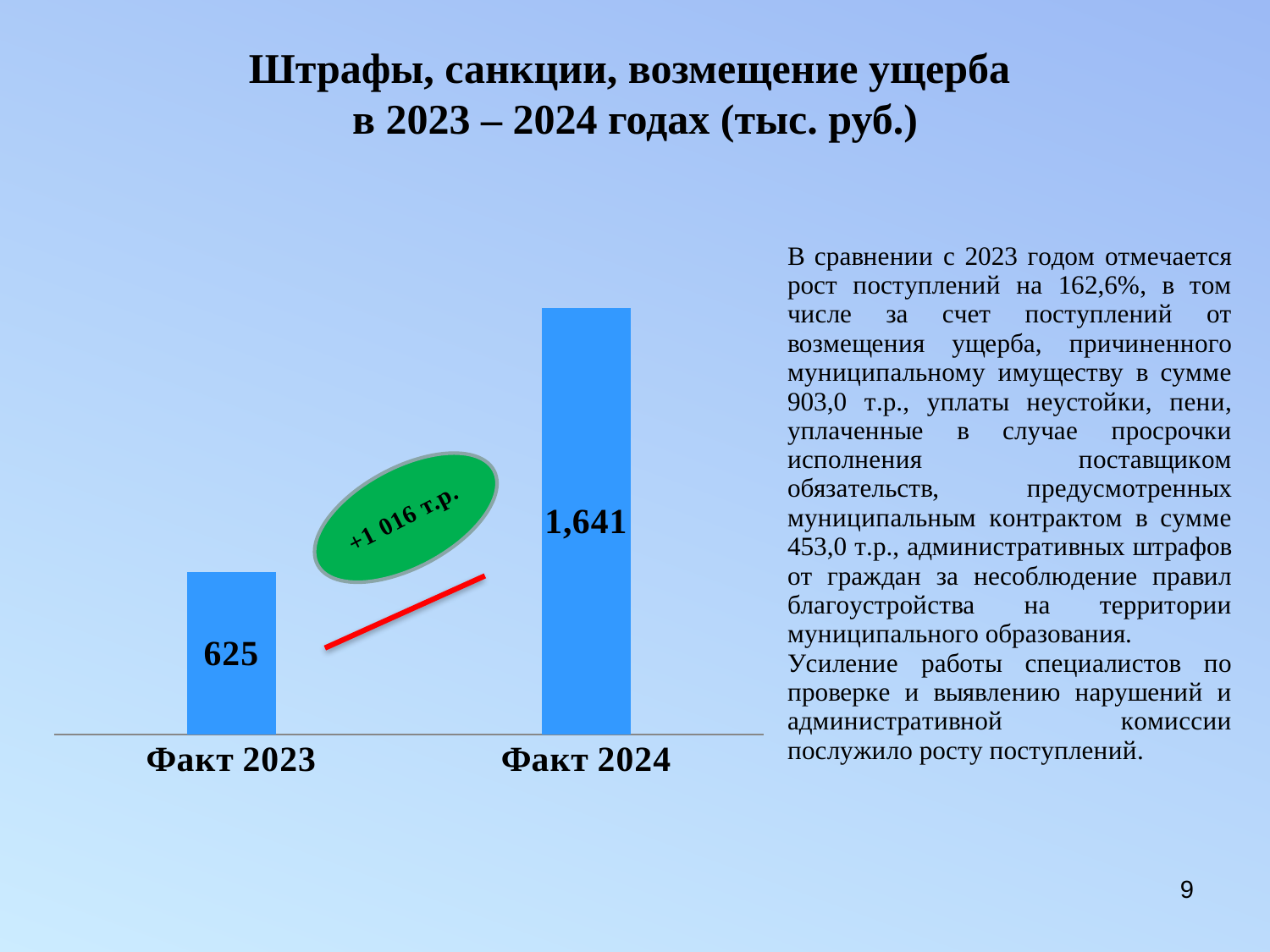
Which is larger, the value for Факт 2023 or the value for Факт 2024? Факт 2024 Which category has the lowest value? Факт 2023 What kind of chart is shown on the slide? bar chart What is the value for Факт 2023? 625 Do the values rise or fall from Факт 2023 to Факт 2024? rise What text is written in the green oval on the chart? +1 016 т.р. Which category has the highest value? Факт 2024 What is the difference between the values for Факт 2024 and Факт 2023? 1,016 What is the value for Факт 2024? 1,641 What is the title of the chart? Штрафы, санкции, возмещение ущерба в 2023 – 2024 годах (тыс. руб.) How many categories are shown in the chart? 2